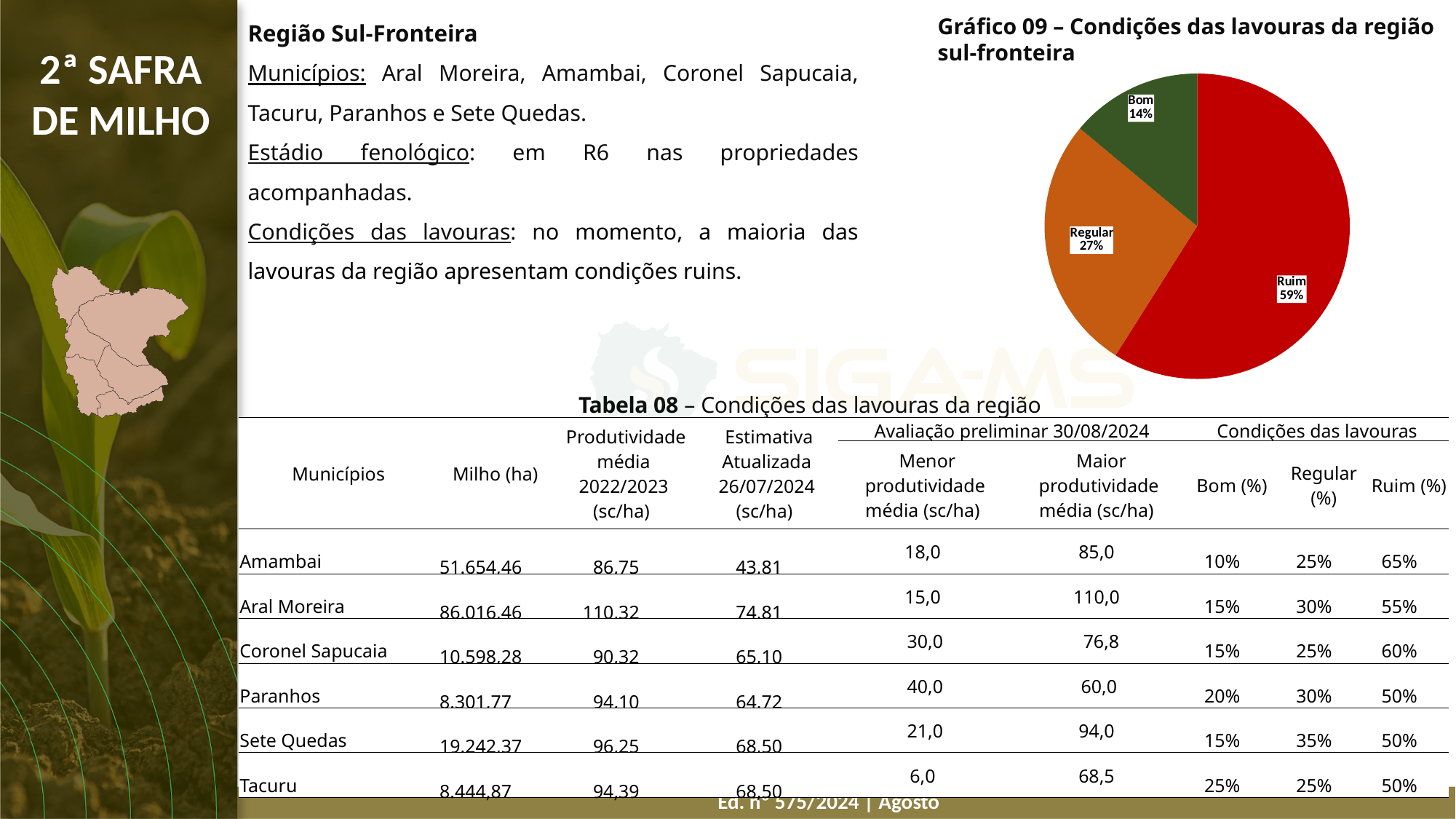
What kind of chart is Gráfico 09? pie chart What is the title of the pie chart on the slide? Gráfico 09 – Condições das lavouras da região sul-fronteira Which category has the largest slice in Gráfico 09? Ruim In Gráfico 09, which slice is larger, Regular or Bom? Regular In Gráfico 09, what share of the lavouras is classified as Regular? 27% In Gráfico 09, what is the difference in percentage points between the Regular and Bom slices? 13 In Gráfico 09, what share of the lavouras is classified as Ruim? 59% How many slices does the pie chart in Gráfico 09 have? 3 What colour is the Ruim slice in Gráfico 09? red In Gráfico 09, what is the difference in percentage points between the Ruim and Regular slices? 32 In Gráfico 09, what share of the lavouras is classified as Bom? 14% Which category has the smallest slice in Gráfico 09? Bom